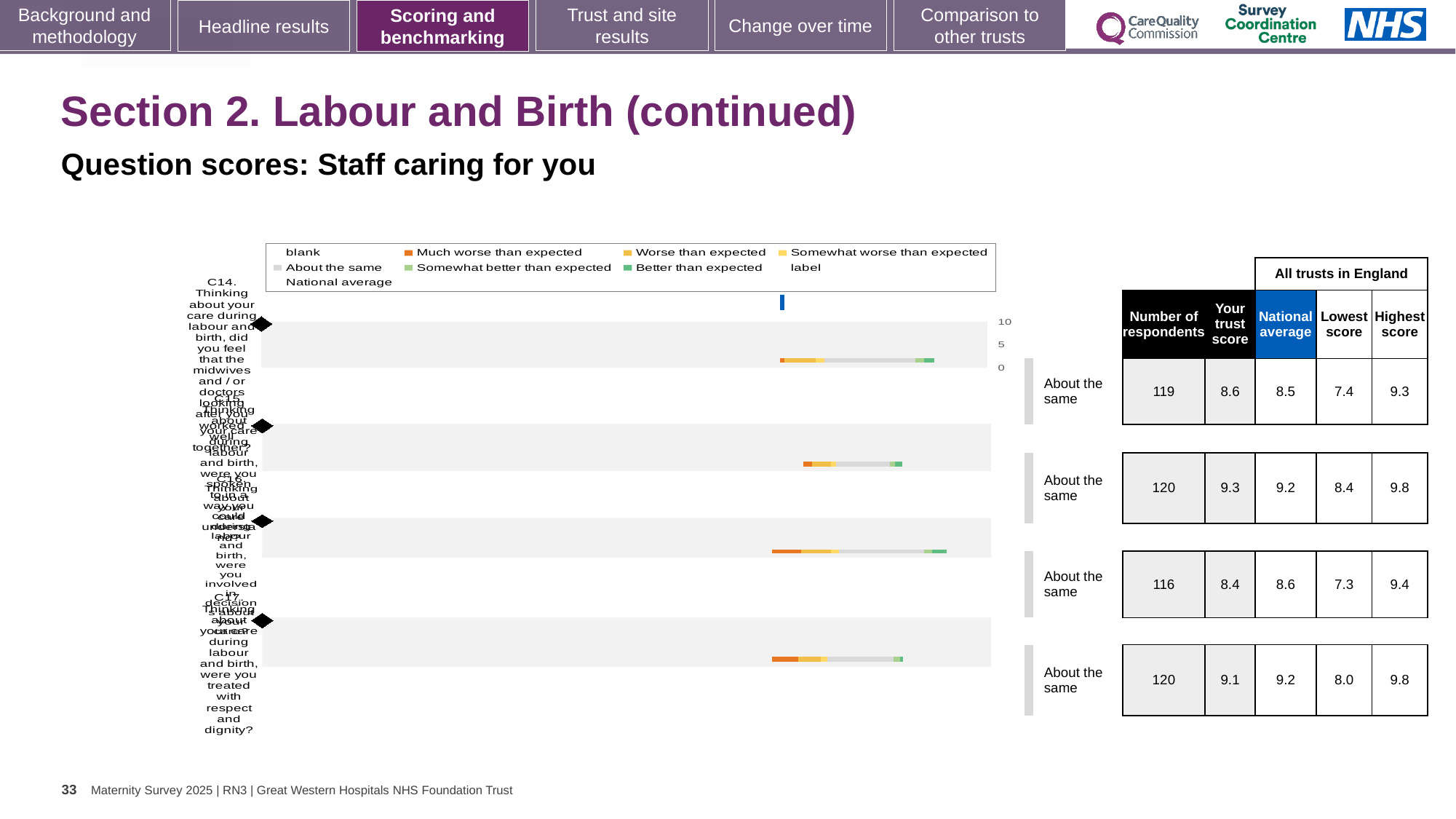
What is the 'Your trust score' for the first question row (C14)? 8.6 What kind of chart is shown on the slide? bar chart For the first question row (C14), which is larger: 'Your trust score' or the national average? Your trust score What benchmark category is shown for all four question rows? About the same For the second question row (C15), what is the difference between 'Your trust score' and the national average? 0.1 Which question row has the highest 'Your trust score'? C15 (second row), 9.3 Which question row has the lowest 'Your trust score'? C16 (third row), 8.4 What is the highest tick value shown on the chart's axis? 10 How many entries does the chart legend list? 9 What colour does the legend use for 'Much worse than expected'? orange How many question rows are plotted in the chart? 4 What is the number of respondents for the second question row (C15)? 120